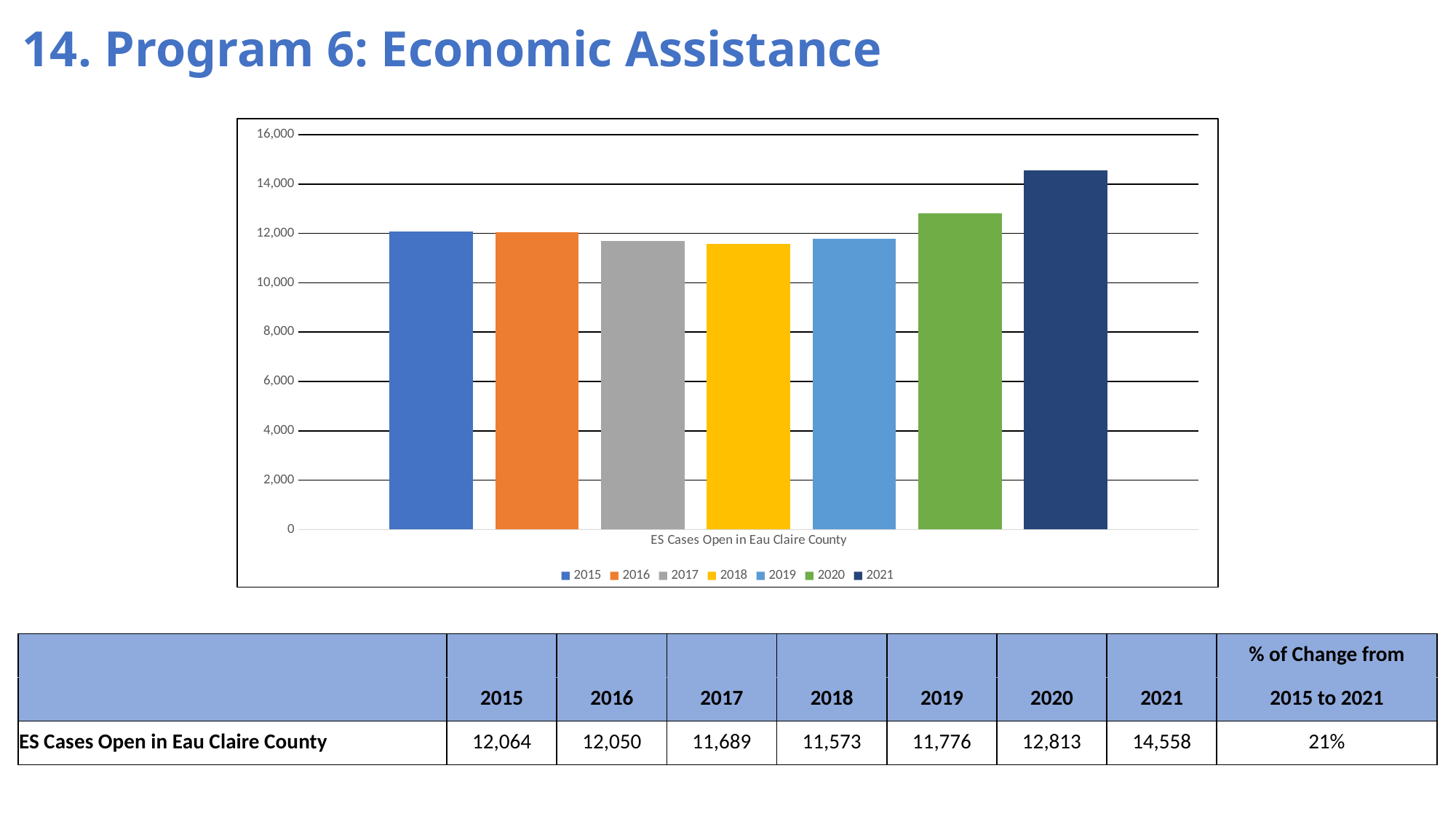
What is the value of ES Cases Open in Eau Claire County for 2021? 14,558 Which year has the highest number of ES Cases Open in Eau Claire County? 2021 What kind of chart is shown on the slide? bar chart What colour is the bar for 2020? green What is the value of ES Cases Open in Eau Claire County for 2018? 11,573 What is the difference between the 2021 and 2020 values for ES Cases Open in Eau Claire County? 1,745 Is the value for 2017 greater or less than 12,000? less How many series does the chart legend list? 7 Which is larger, the value for 2019 or the value for 2020? 2020 Is the value for 2021 greater or less than 14,000? greater What is the value of ES Cases Open in Eau Claire County for 2015? 12,064 Which year has the lowest number of ES Cases Open in Eau Claire County? 2018